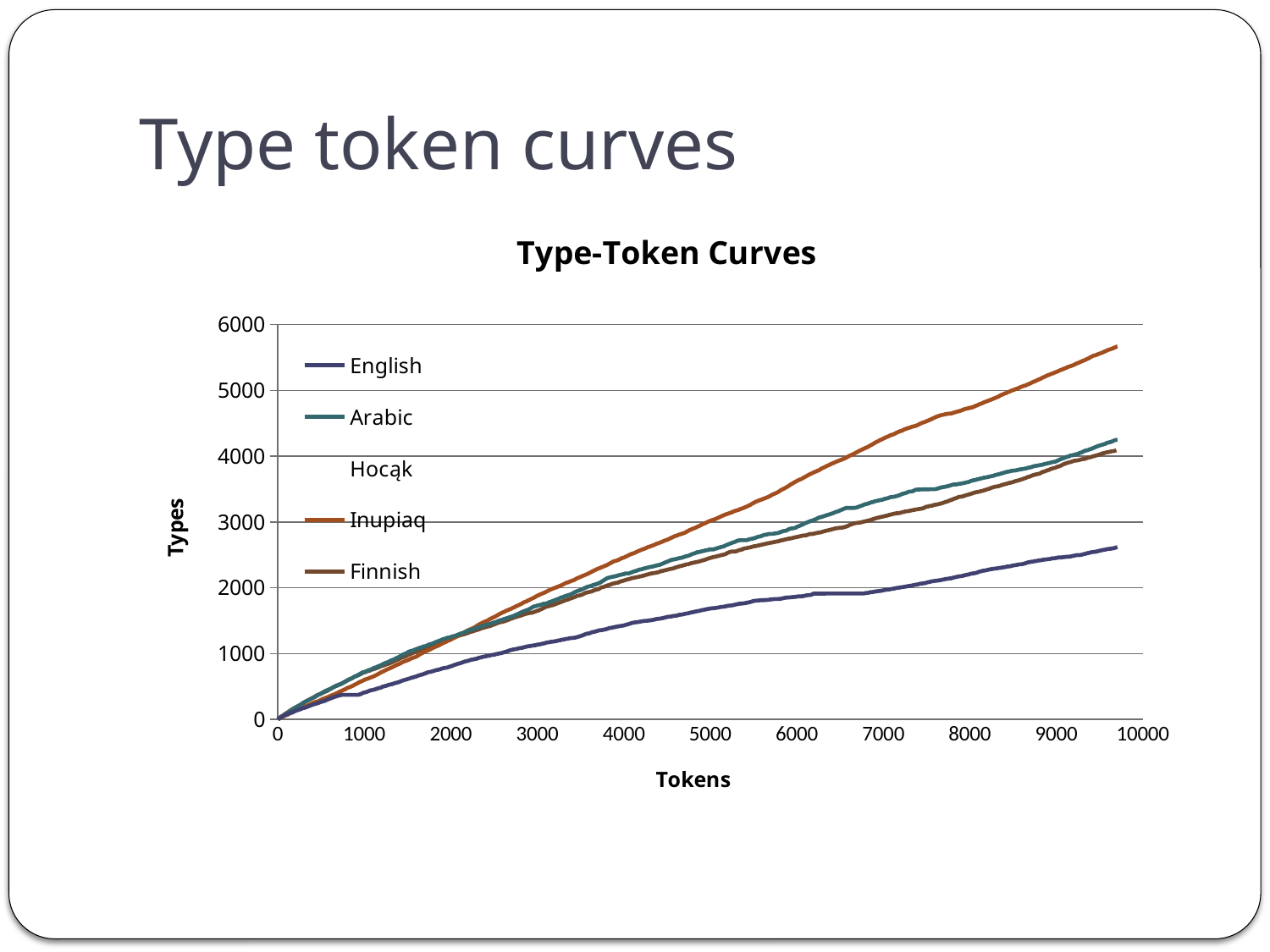
Do the curves rise or fall as the number of tokens increases? rise How many series does the legend list? 5 At 9000 tokens, which series has more types, Inupiaq or Finnish? Inupiaq Is the value for Inupiaq at the right end of the chart greater or less than 5000? greater At 8000 tokens, which series has more types, Arabic or English? Arabic Is the value for English at the right end of the chart greater or less than 3000? less Is the value for Arabic at 8000 tokens greater or less than 3000? greater What is the title of the chart? Type-Token Curves Which series has the lowest number of types at the right end of the chart? English Which series has the highest number of types at the right end of the chart? Inupiaq What kind of chart is shown on the slide? line chart